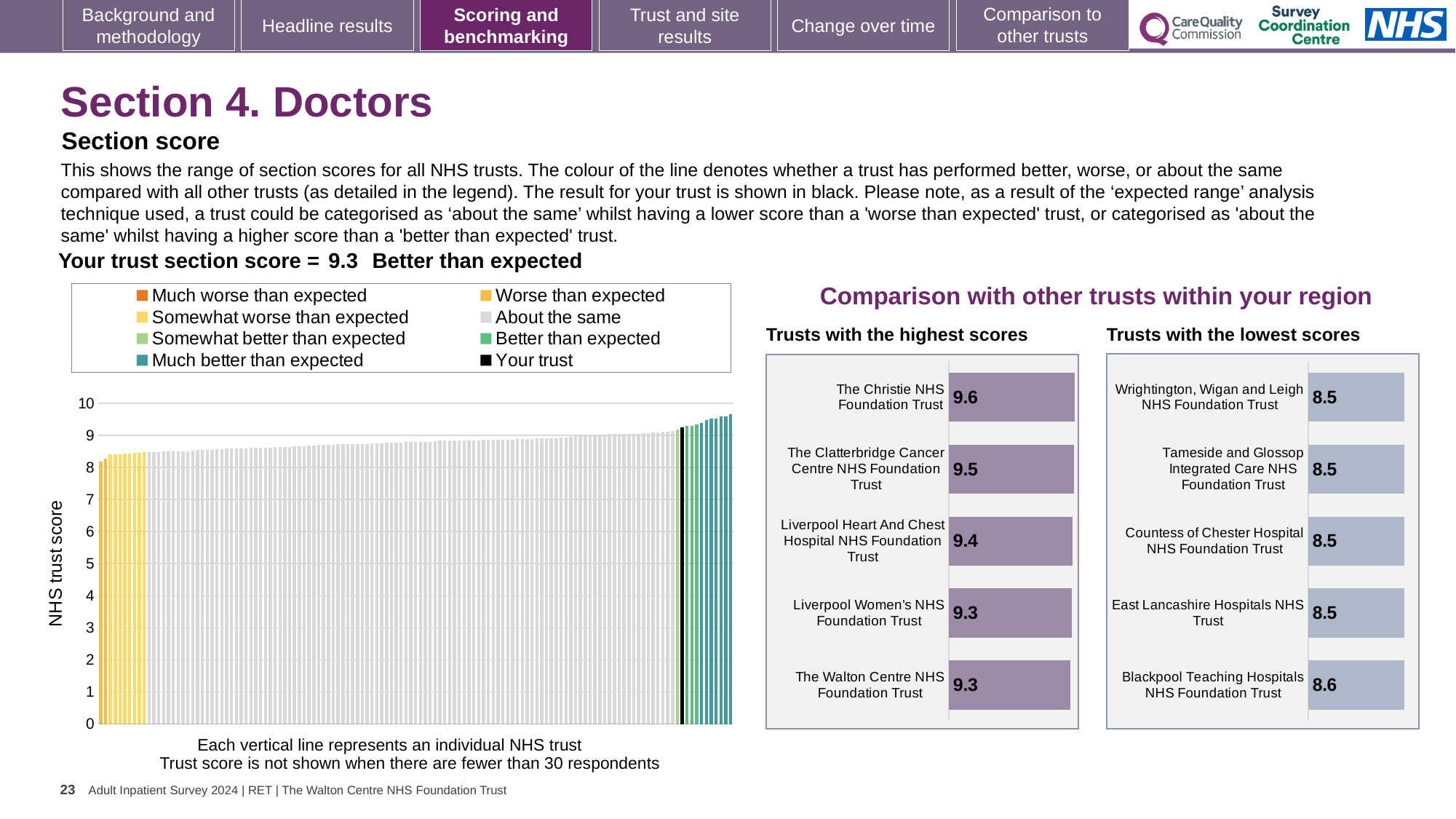
In the 'Trusts with the lowest scores' chart, what is the score for Blackpool Teaching Hospitals NHS Foundation Trust? 8.6 In the 'Trusts with the highest scores' chart, which has the higher score: The Clatterbridge Cancer Centre NHS Foundation Trust or Liverpool Heart And Chest Hospital NHS Foundation Trust? The Clatterbridge Cancer Centre NHS Foundation Trust In the 'NHS trust score' chart on the left, do the values rise or fall from left to right? Rise In the 'Trusts with the highest scores' chart, what is the score for The Christie NHS Foundation Trust? 9.6 In the 'Trusts with the lowest scores' chart, what is the difference between the scores of Blackpool Teaching Hospitals NHS Foundation Trust and Wrightington, Wigan and Leigh NHS Foundation Trust? 0.1 How many trusts are listed in the 'Trusts with the lowest scores' chart? 5 In the 'NHS trust score' chart on the left, what colour is used to show 'Your trust'? Black In the 'Trusts with the highest scores' chart, what is the difference between the scores of The Christie NHS Foundation Trust and The Walton Centre NHS Foundation Trust? 0.3 In the 'Trusts with the lowest scores' chart, which trust has the highest score shown? Blackpool Teaching Hospitals NHS Foundation Trust How many entries does the legend of the 'NHS trust score' chart on the left list? 8 In the 'Trusts with the highest scores' chart, which trust has the highest score? The Christie NHS Foundation Trust What type of chart is the large 'NHS trust score' chart on the left of the slide? Bar chart